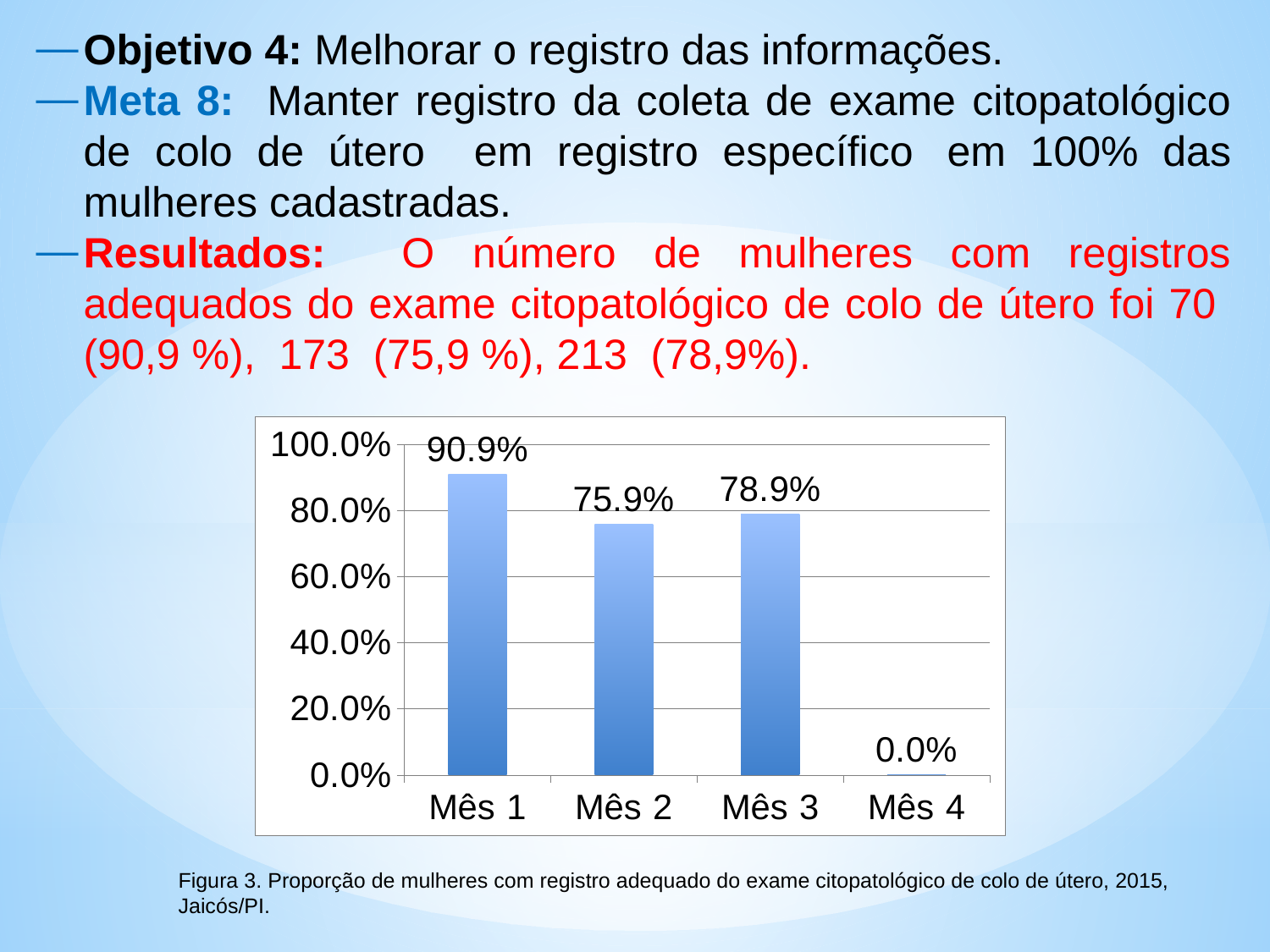
Which month has the lowest value? Mês 4 What is the value for Mês 2? 75.9% Is the value for Mês 3 greater or less than 80.0%? less Which month has the highest value? Mês 1 How many categories are shown on the x axis? 4 Which is larger, the value for Mês 2 or Mês 3? Mês 3 What is the caption given for the figure below the chart? Figura 3. Proporção de mulheres com registro adequado do exame citopatológico de colo de útero, 2015, Jaicós/PI. What is the value for Mês 3? 78.9% What is the value for Mês 4? 0.0% What is the difference between the values for Mês 1 and Mês 2? 15.0% What kind of chart is shown? bar chart What is the value for Mês 1? 90.9%